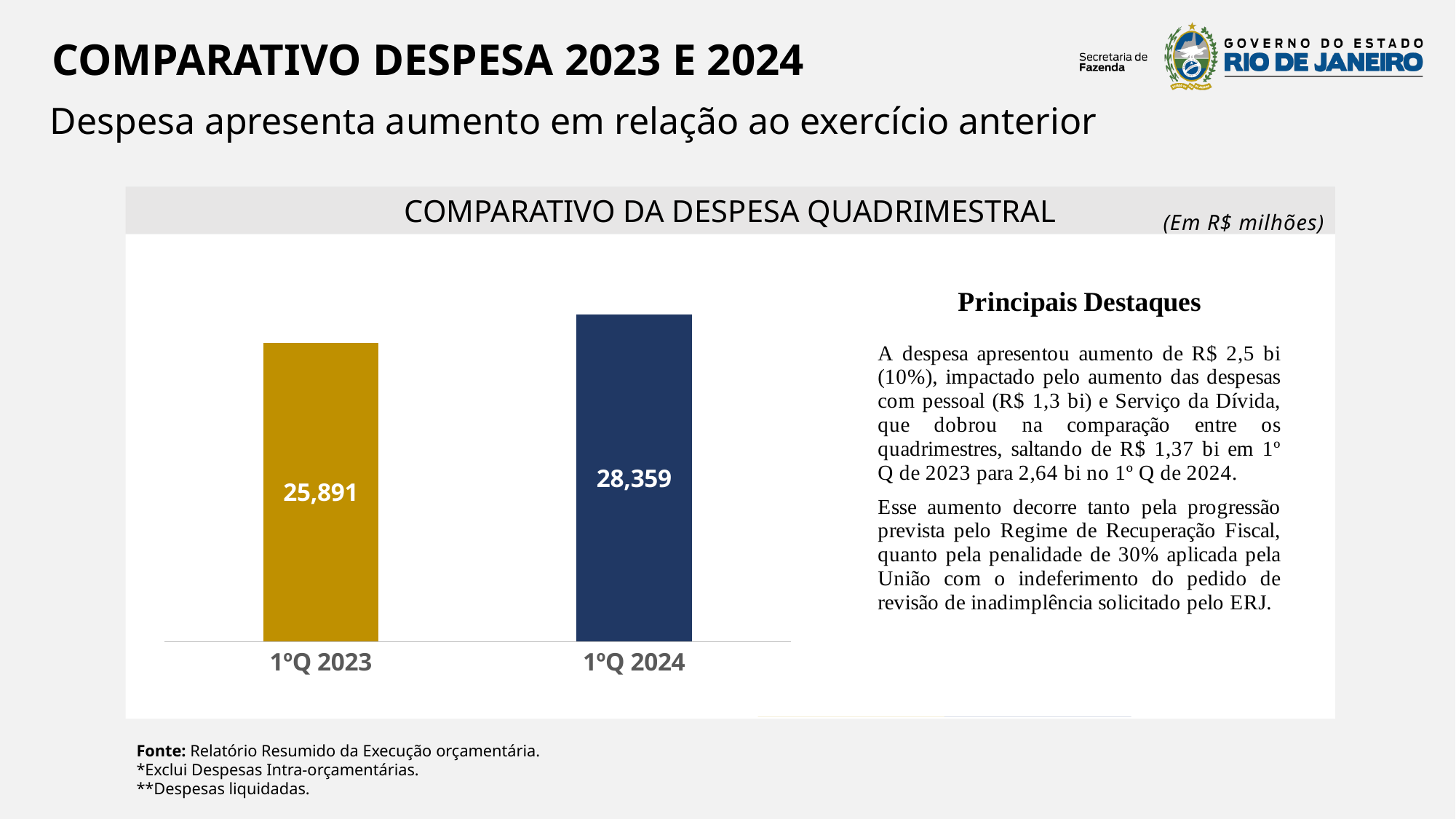
What is the value for 1ºQ 2023? 25,891 Which period has the highest value? 1ºQ 2024 How many bars are plotted in the chart? 2 What is the value for 1ºQ 2024? 28,359 Do the values rise or fall from 1ºQ 2023 to 1ºQ 2024? Rise What is the title of the chart? COMPARATIVO DA DESPESA QUADRIMESTRAL What is the difference between the values for 1ºQ 2024 and 1ºQ 2023? 2,468 What kind of chart is shown on the slide? Bar chart Which is larger, the value for 1ºQ 2023 or the value for 1ºQ 2024? 1ºQ 2024 In what unit are the chart values expressed? R$ milhões Which period has the lowest value? 1ºQ 2023